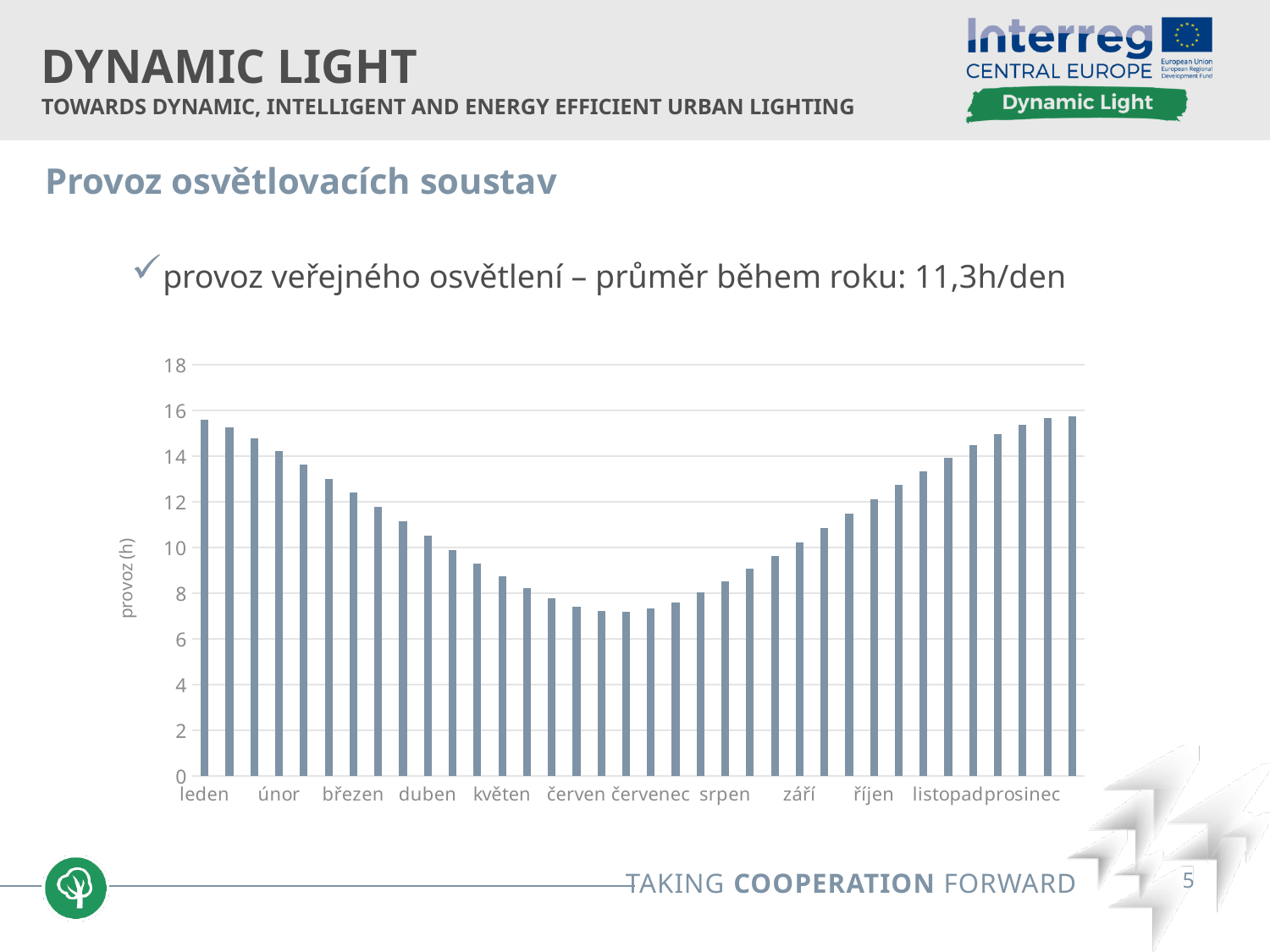
Do the values rise or fall from leden to červenec? fall Which is larger, the first bar for březen or the first bar for září? březen Is the value of the first bar for červenec greater or less than 8? less What kind of chart is shown on the slide? bar chart Is the value of the last bar for prosinec greater or less than 14? greater Is the value of the first bar for duben greater or less than 10? greater How many month categories are labelled on the x axis of the chart? 12 What is the label on the vertical axis of the chart? provoz (h) Which is larger, the first bar for leden or the first bar for červenec? leden What is the highest value shown on the vertical axis of the chart? 18